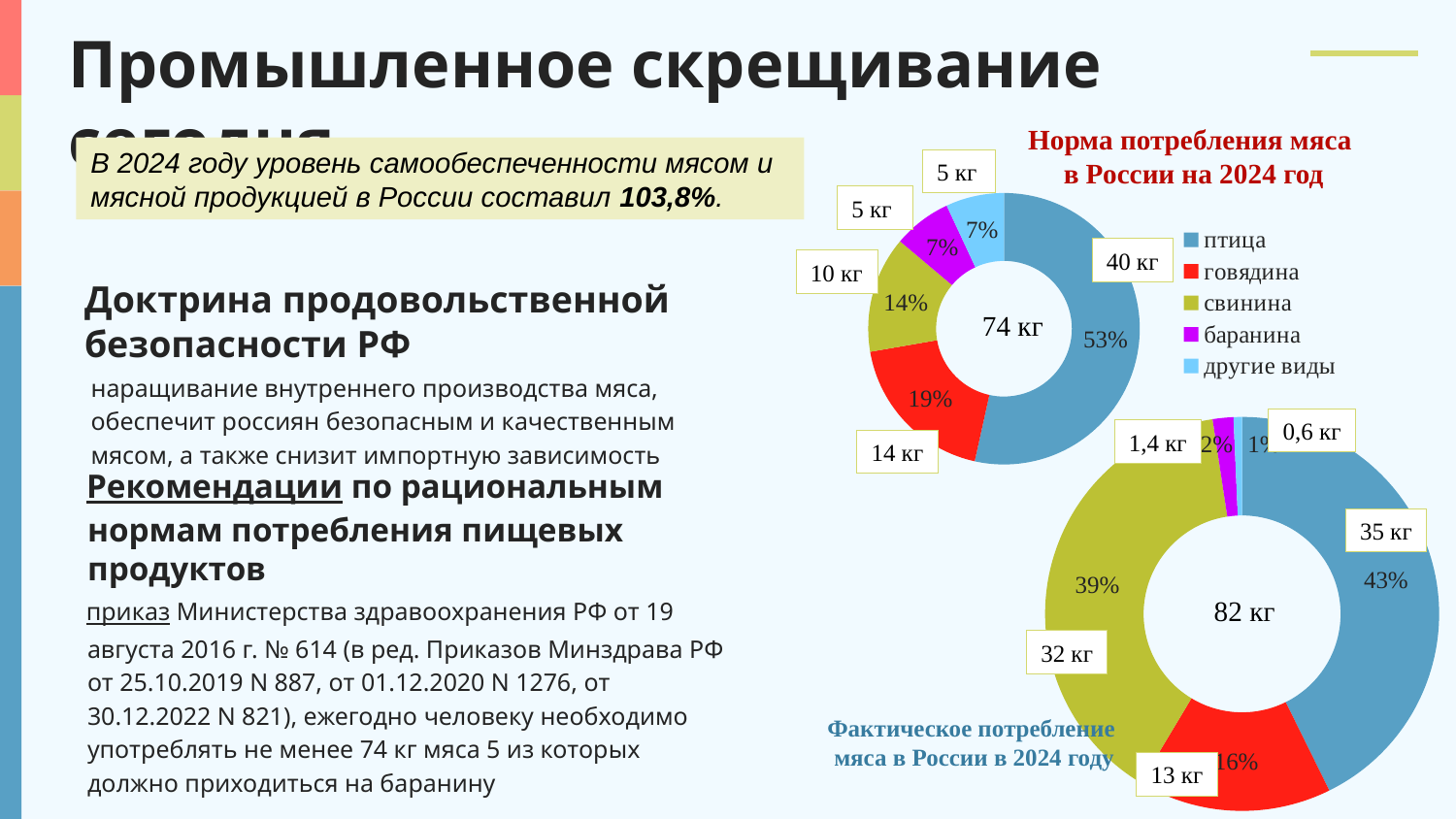
In the chart 'Фактическое потребление мяса в России в 2024 году', what total is shown in the centre of the doughnut? 82 кг In the chart 'Фактическое потребление мяса в России в 2024 году', what share of the total does птица have? 43% In the chart 'Норма потребления мяса в России на 2024 год', what is the value for птица? 40 кг In the chart 'Норма потребления мяса в России на 2024 год', what is the difference between the values for птица and говядина? 26 кг In the chart 'Норма потребления мяса в России на 2024 год', which category is the largest? птица In the chart 'Фактическое потребление мяса в России в 2024 году', which is larger: свинина or говядина? свинина What kind of chart is 'Норма потребления мяса в России на 2024 год'? Doughnut (pie) chart In the chart 'Фактическое потребление мяса в России в 2024 году', what is the value for баранина? 1,4 кг In the chart 'Норма потребления мяса в России на 2024 год', what share of the total does говядина have? 19% In the chart 'Норма потребления мяса в России на 2024 год', what total is shown in the centre of the doughnut? 74 кг How many entries does the legend of the chart 'Норма потребления мяса в России на 2024 год' list? 5 In the chart 'Фактическое потребление мяса в России в 2024 году', what is the value for свинина? 32 кг